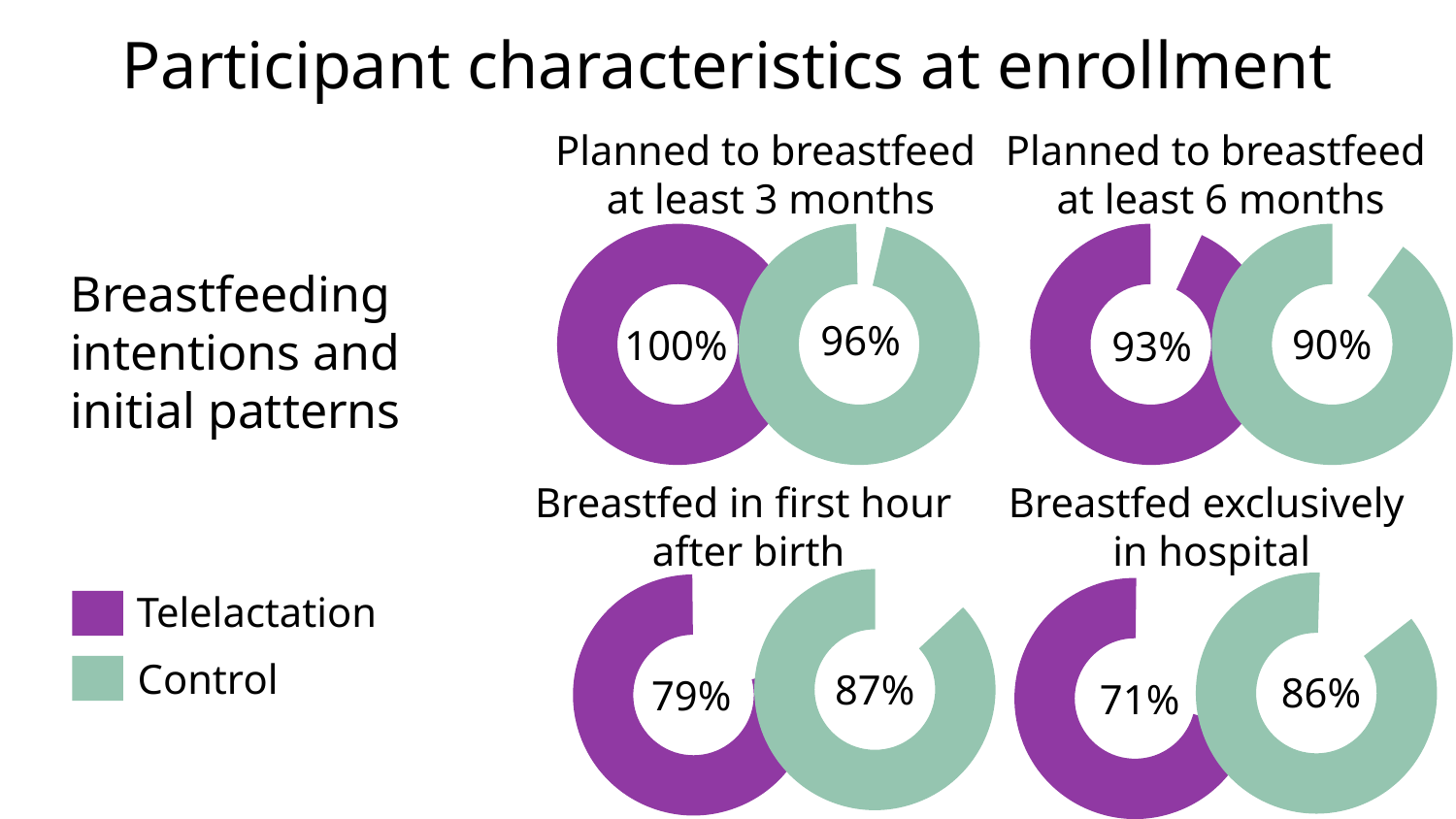
Which colour represents the Control group in the legend? Green In the 'Breastfed exclusively in hospital' chart, what is the difference between the Control and Telelactation values? 15% In the 'Breastfed in first hour after birth' chart, what is the value for Telelactation? 79% In the 'Planned to breastfeed at least 6 months' chart, what is the value for Control? 90% In the 'Planned to breastfeed at least 6 months' chart, which group has the larger value, Telelactation or Control? Telelactation In the 'Planned to breastfeed at least 3 months' chart, what is the value for Telelactation? 100% In the 'Breastfed in first hour after birth' chart, which group has the larger value, Telelactation or Control? Control In the 'Planned to breastfeed at least 6 months' chart, what is the value for Telelactation? 93% In the 'Breastfed exclusively in hospital' chart, what is the value for Control? 86% How many groups does the legend list? 2 In the 'Planned to breastfeed at least 3 months' chart, what is the value for Control? 96% What kind of chart is used to show the 'Breastfed exclusively in hospital' values? Donut chart